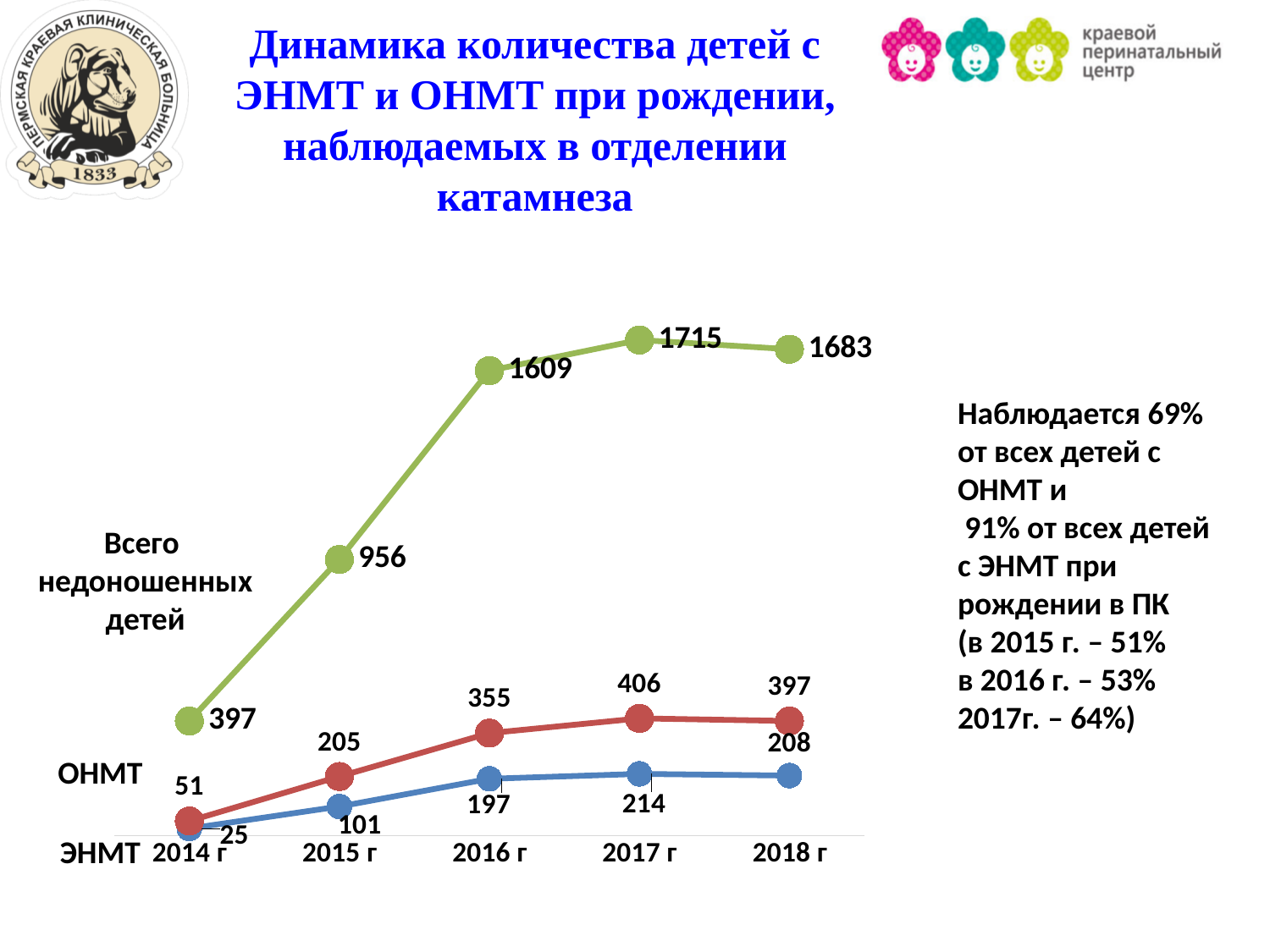
What type of chart is shown on the slide? line chart How many years are shown on the x axis? 5 What is the value for ОНМТ in 2017 г? 406 In which year is the value for "Всего недоношенных детей" highest? 2017 г What is the value for ЭНМТ in 2015 г? 101 Does the value for ЭНМТ rise or fall from 2014 г to 2017 г? rise What is the value for "Всего недоношенных детей" in 2016 г? 1609 What is the difference between the "Всего недоношенных детей" values in 2015 г and 2014 г? 559 What is the difference between the ОНМТ values in 2017 г and 2018 г? 9 Which is larger in 2016 г: the value for ОНМТ or the value for ЭНМТ? ОНМТ How many series are plotted on the chart? 3 In which year is the value for ЭНМТ lowest? 2014 г